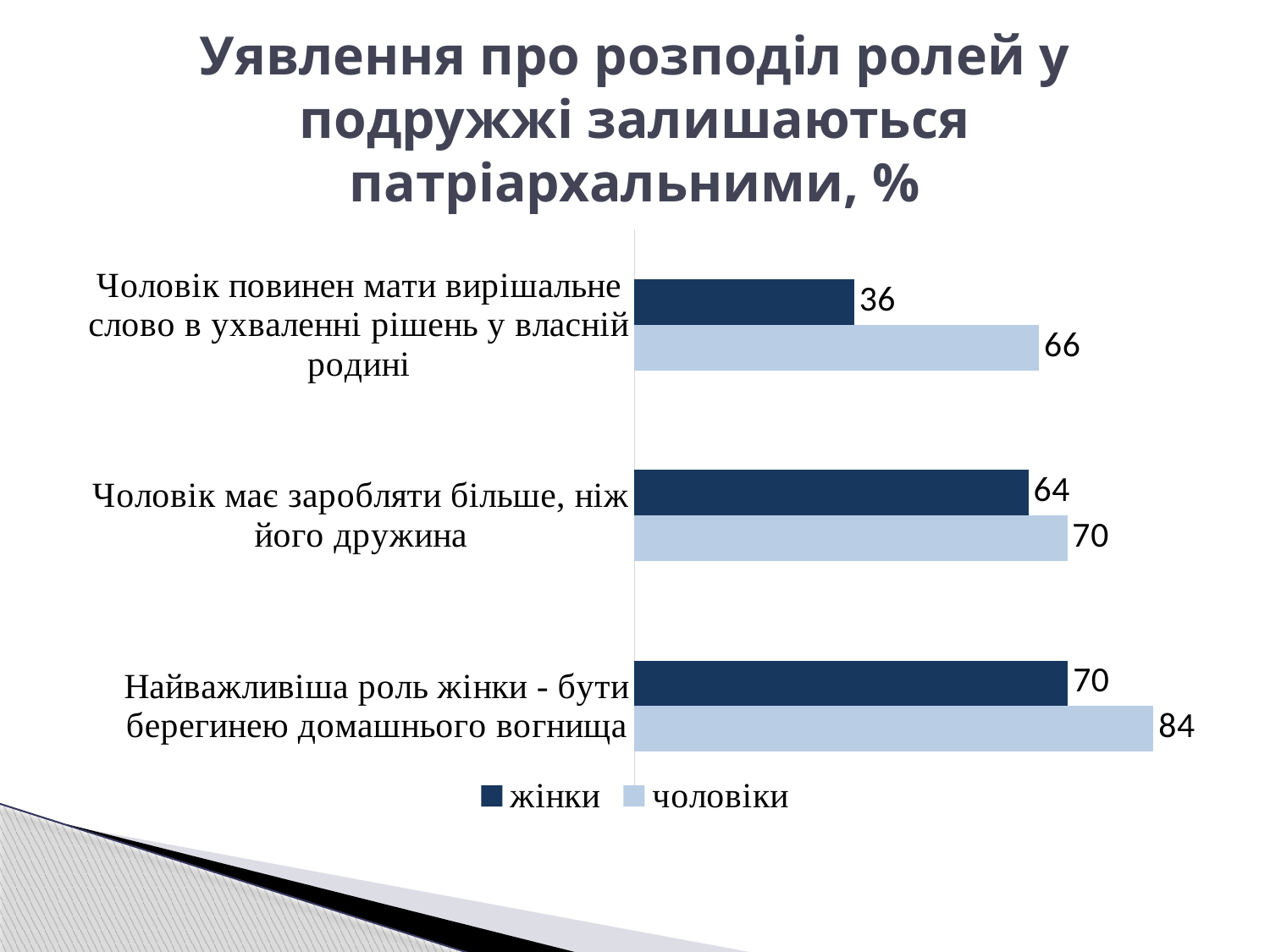
Which series is shown in dark blue? жінки Which statement has the highest value for чоловіки? Найважливіша роль жінки - бути берегинею домашнього вогнища How many statements (categories) are shown on the chart? 3 What is the difference between the чоловіки and жінки values for "Чоловік повинен мати вирішальне слово в ухваленні рішень у власній родині"? 30 For "Чоловік має заробляти більше, ніж його дружина", which group has the larger value, жінки or чоловіки? чоловіки How many series does the legend list? 2 Which statement has the lowest value for жінки? Чоловік повинен мати вирішальне слово в ухваленні рішень у власній родині What is the difference between the чоловіки and жінки values for "Найважливіша роль жінки - бути берегинею домашнього вогнища"? 14 What kind of chart is shown on the slide? bar chart What value is shown for чоловіки on the statement "Найважливіша роль жінки - бути берегинею домашнього вогнища"? 84 What value is shown for жінки on the statement "Чоловік повинен мати вирішальне слово в ухваленні рішень у власній родині"? 36 What value is shown for чоловіки on the statement "Чоловік має заробляти більше, ніж його дружина"? 70